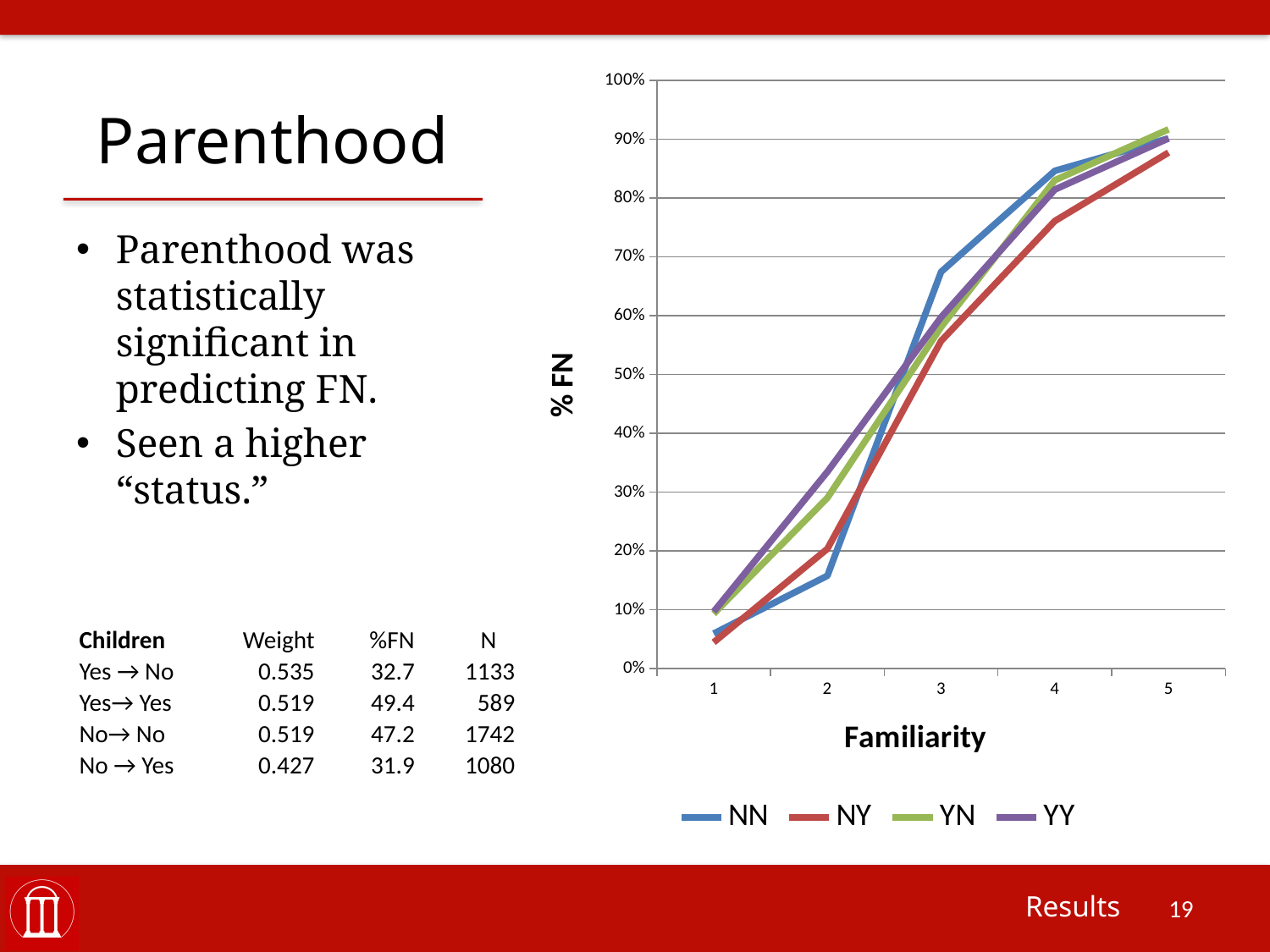
Do the % FN values rise or fall as Familiarity increases from 1 to 5? rise At Familiarity 2, which series has the larger value, YY or NN? YY Is the value for YY at Familiarity 1 greater or less than 20%? less Is the value for NY at Familiarity 4 greater or less than 80%? less At Familiarity 3, which series has the larger value, NN or NY? NN Which series has the lowest value at Familiarity 4? NY What kind of chart is shown on the slide? line chart Is the value for NN at Familiarity 3 greater or less than 60%? greater How many series does the chart's legend list? 4 What is the title of the chart's x axis? Familiarity How many Familiarity levels are plotted along the x axis of the chart? 5